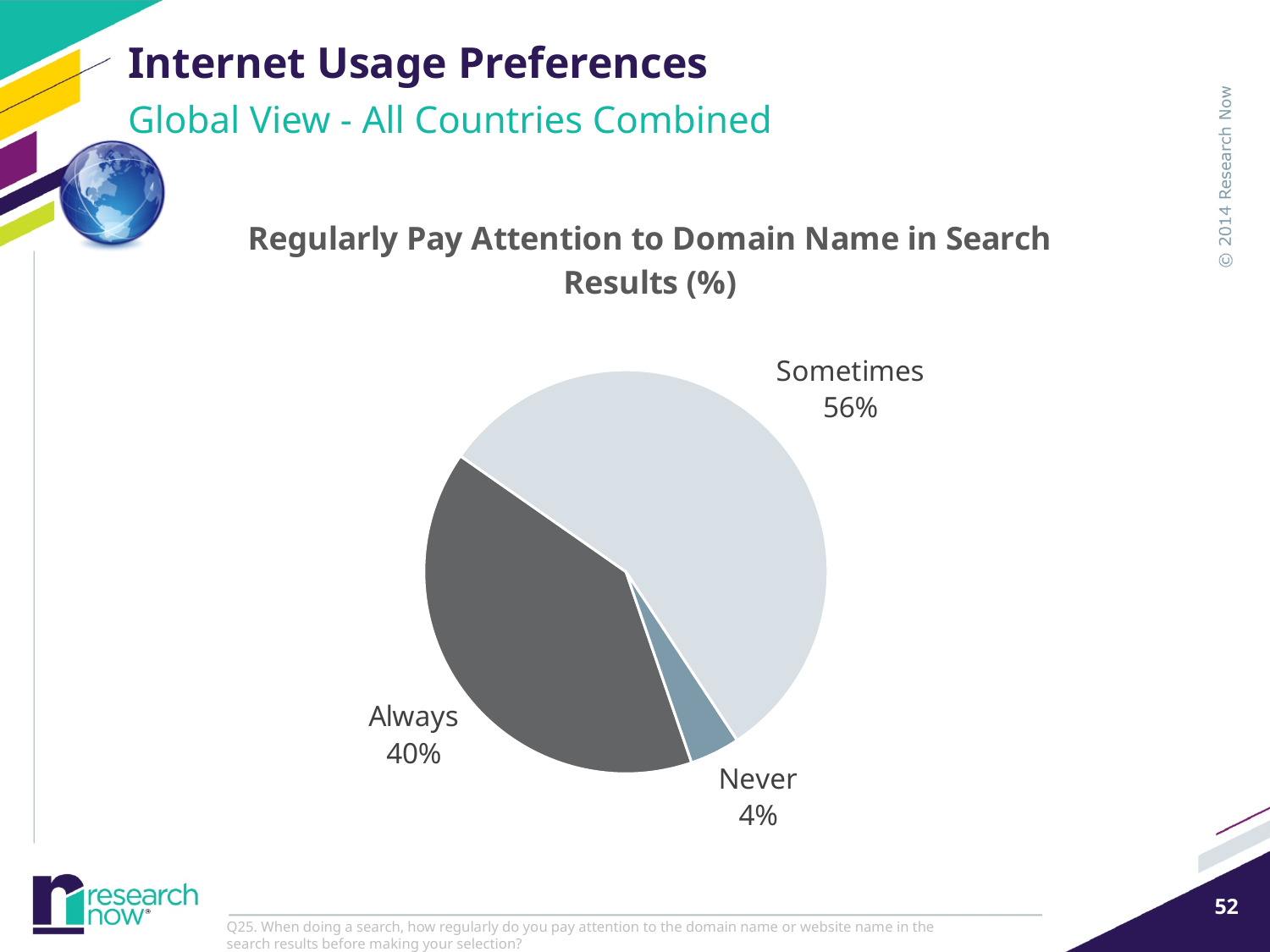
What percentage of respondents say they Never pay attention to the domain name in search results? 4% What is the difference in percentage points between the Always and Never slices? 36 Which category has the largest share of the pie? Sometimes What is the title of the chart? Regularly Pay Attention to Domain Name in Search Results (%) Which is larger, the Always slice or the Never slice? Always Which category has the smallest share of the pie? Never What percentage of respondents say they Always pay attention to the domain name in search results? 40% What percentage of respondents say they Sometimes pay attention to the domain name in search results? 56% What type of chart is shown on the slide? Pie chart How many categories are shown in the pie chart? 3 What is the difference in percentage points between the Sometimes and Always slices? 16 What is the combined share of the Always and Sometimes slices? 96%